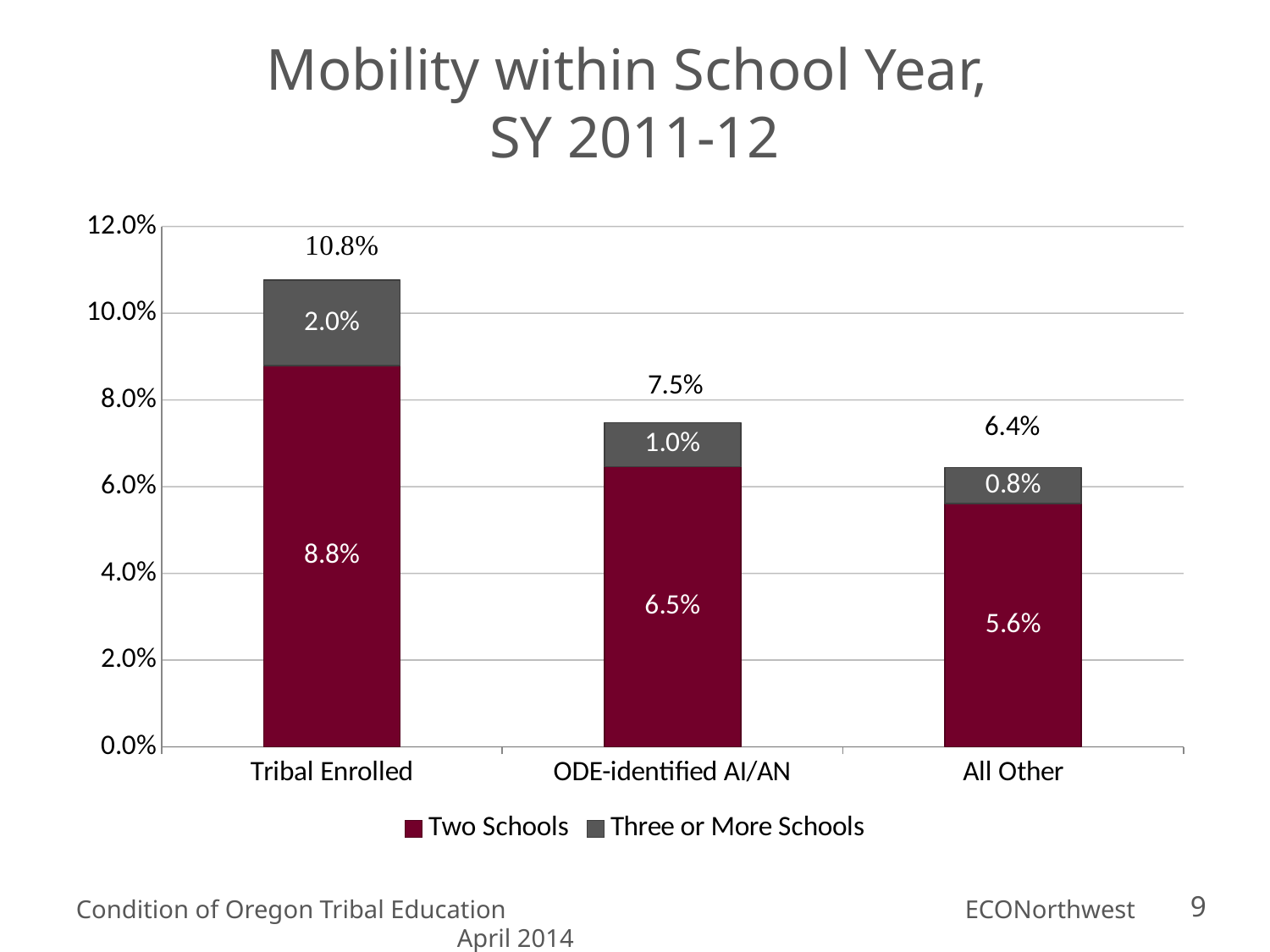
Which category has the highest total mobility? Tribal Enrolled What is the total of the stacked bar for Tribal Enrolled? 10.8% How many series does the legend list? 2 What is the Three or More Schools value for ODE-identified AI/AN? 1.0% Which category has the lowest Two Schools value? All Other What is the difference between the Two Schools values for Tribal Enrolled and All Other? 3.2% What is the Two Schools value for Tribal Enrolled? 8.8% What kind of chart is shown on the slide? Stacked bar chart What is the total of the stacked bar for ODE-identified AI/AN? 7.5% What is the Three or More Schools value for All Other? 0.8% Which is larger, the Three or More Schools value for Tribal Enrolled or for ODE-identified AI/AN? Tribal Enrolled How many categories are shown on the x axis? 3